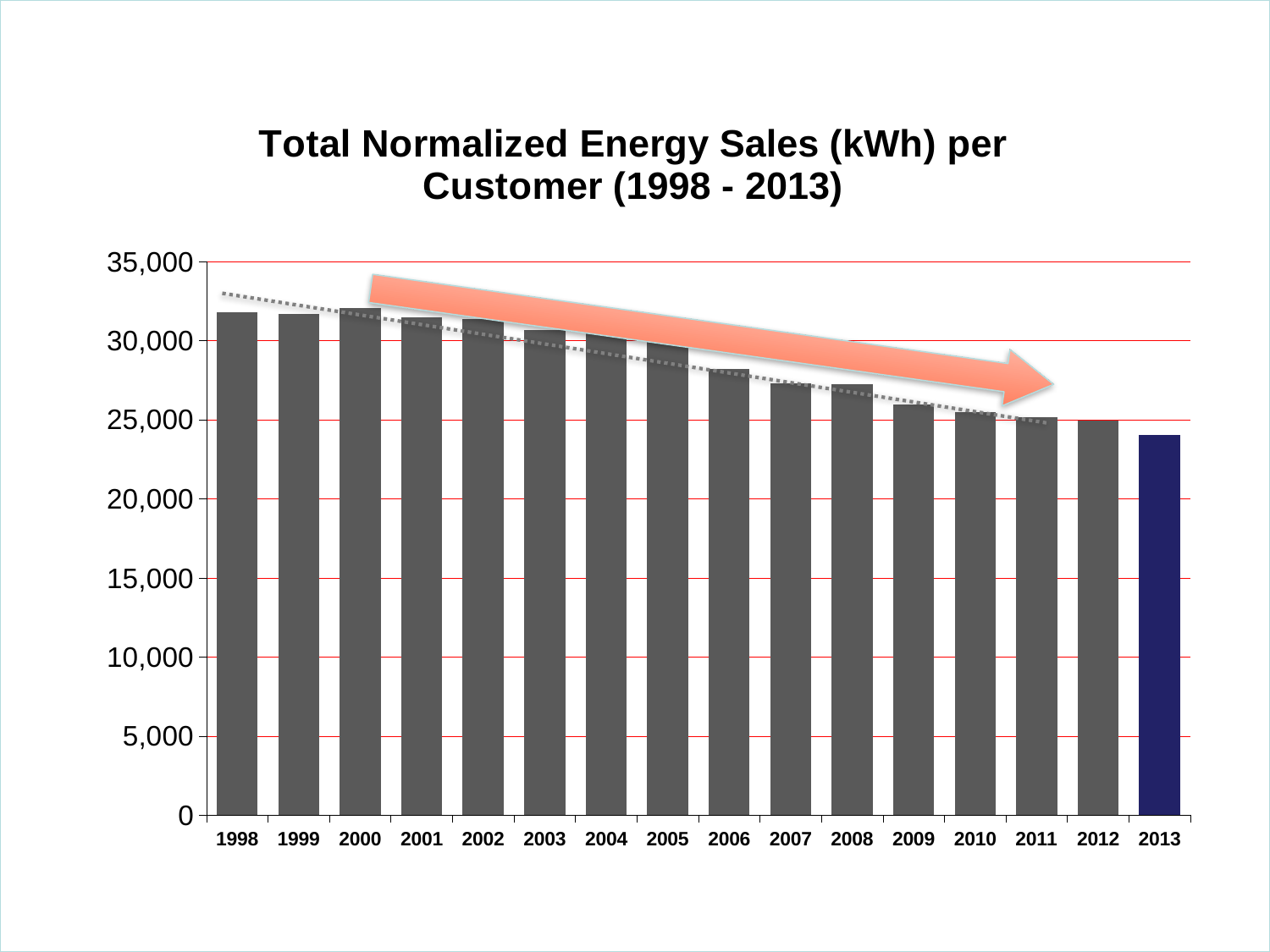
Is the value for 1998 greater or less than 30,000? greater How many years (bars) are plotted on the chart? 16 Do the values generally rise or fall from 1998 to 2013? fall Which year has the lowest energy sales per customer? 2013 Is the value for 2013 greater or less than 25,000? less Is the value for 2006 greater or less than 25,000? greater What kind of chart is shown on the slide? bar chart Which year's bar is shown in a different colour (dark blue) from the others? 2013 What is the title of the chart? Total Normalized Energy Sales (kWh) per Customer (1998 - 2013) Which is larger, the value for 2002 or the value for 2009? 2002 Which is larger, the value for 1998 or the value for 2013? 1998